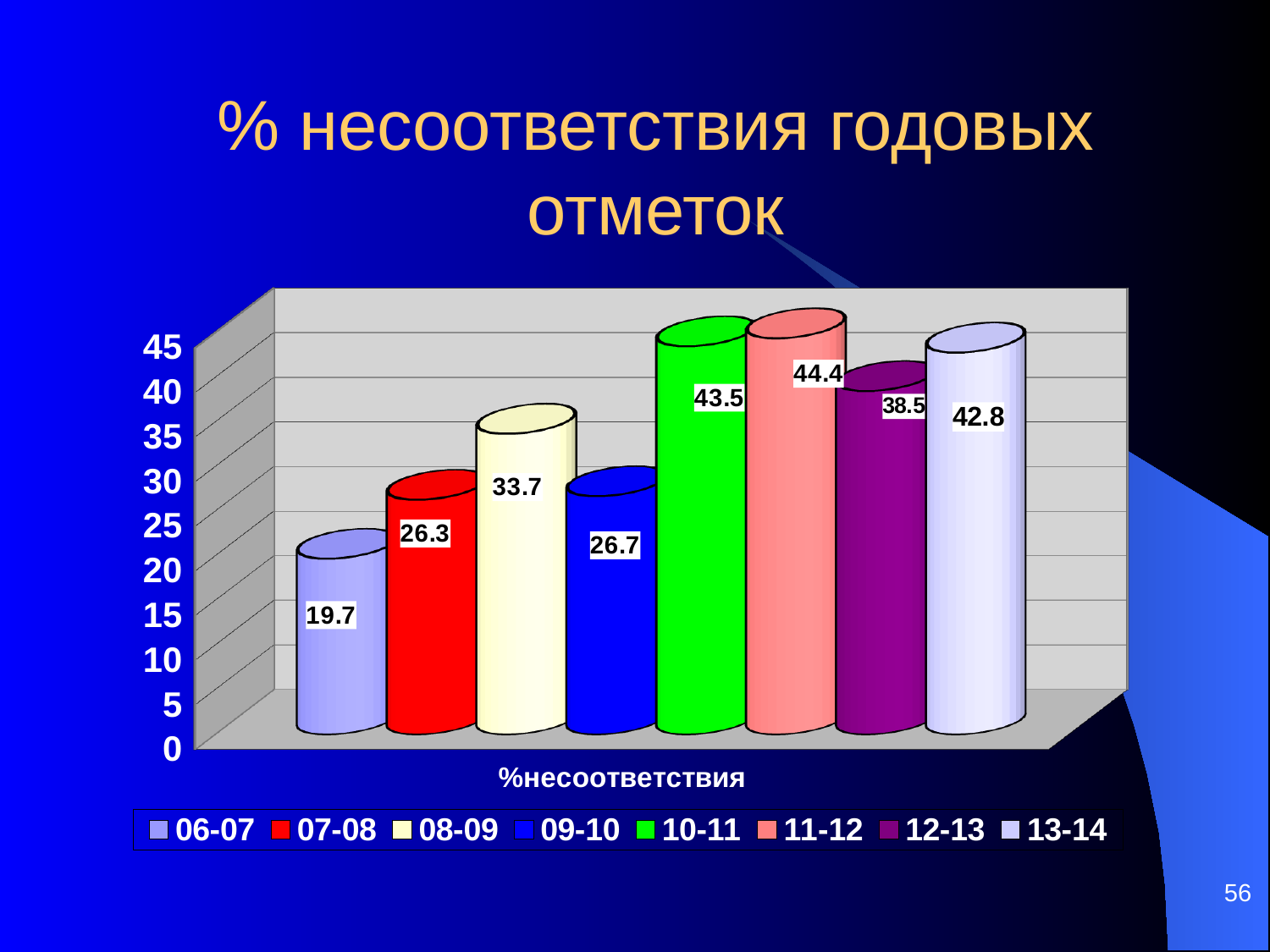
What is the difference between the values for 08-09 and 07-08? 7.4 Which series has the lowest value? 06-07 What is the difference between the values for 13-14 and 06-07? 23.1 What is the value for 10-11? 43.5 Which series has the highest value? 11-12 What is the value for 12-13? 38.5 What kind of chart is shown on the slide? bar chart How many series does the legend list? 8 Is the value for 12-13 greater or less than 35? greater Which is larger, the value for 09-10 or the value for 08-09? 08-09 What is the value for 06-07? 19.7 What is the title of the chart on the slide? % несоответствия годовых отметок